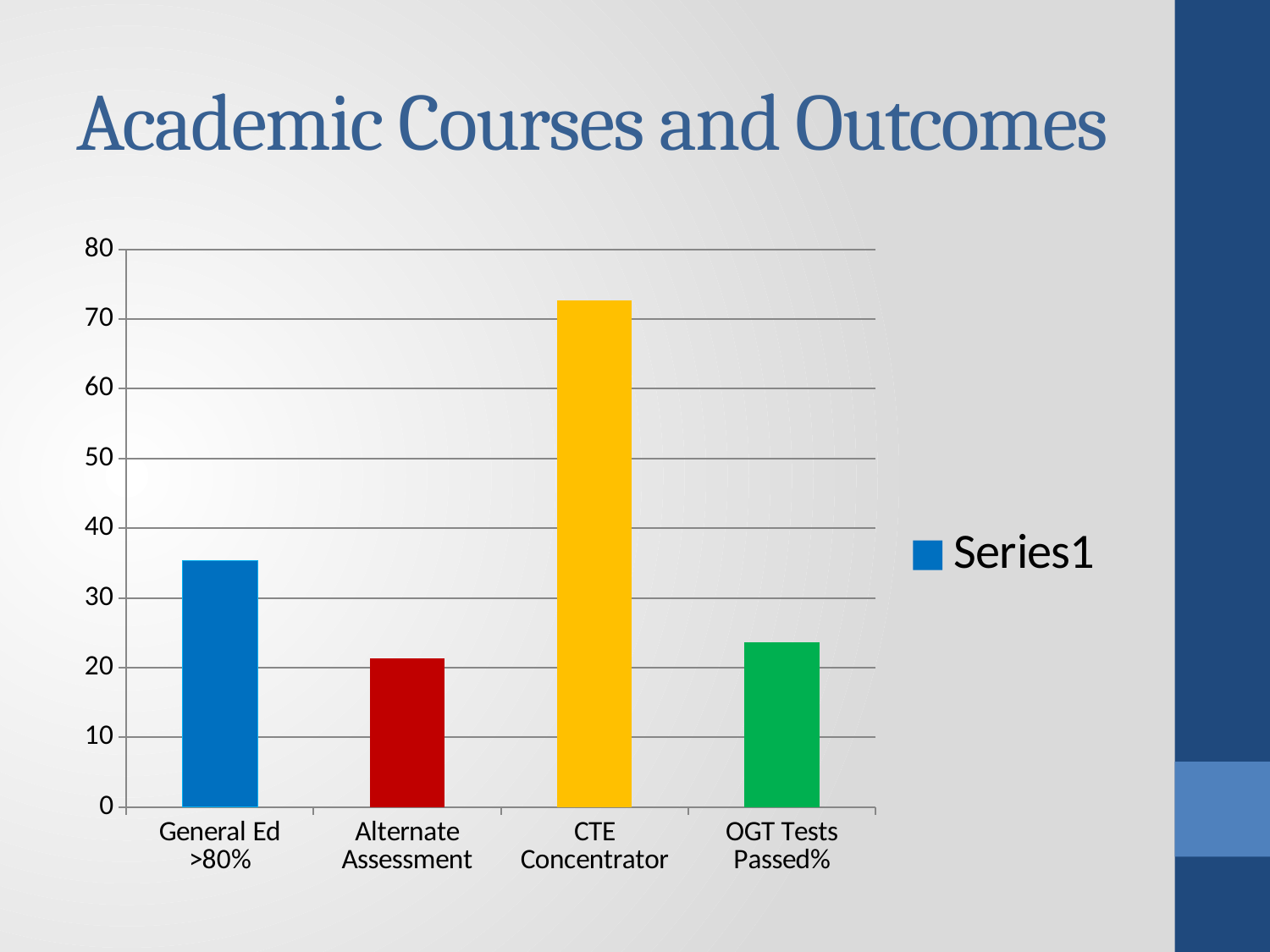
What is the title of the slide containing the chart? Academic Courses and Outcomes How many series does the legend list? 1 Which is larger, the value for General Ed >80% or the value for OGT Tests Passed%? General Ed >80% What kind of chart is shown on the slide? bar chart Is the value for Alternate Assessment greater or less than 20? greater Which category has the lowest bar? Alternate Assessment Is the value for CTE Concentrator greater or less than 70? greater Is the value for OGT Tests Passed% greater or less than 30? less Which is larger, the value for CTE Concentrator or the value for General Ed >80%? CTE Concentrator How many categories are shown on the x axis of the chart? 4 Which category has the highest bar? CTE Concentrator